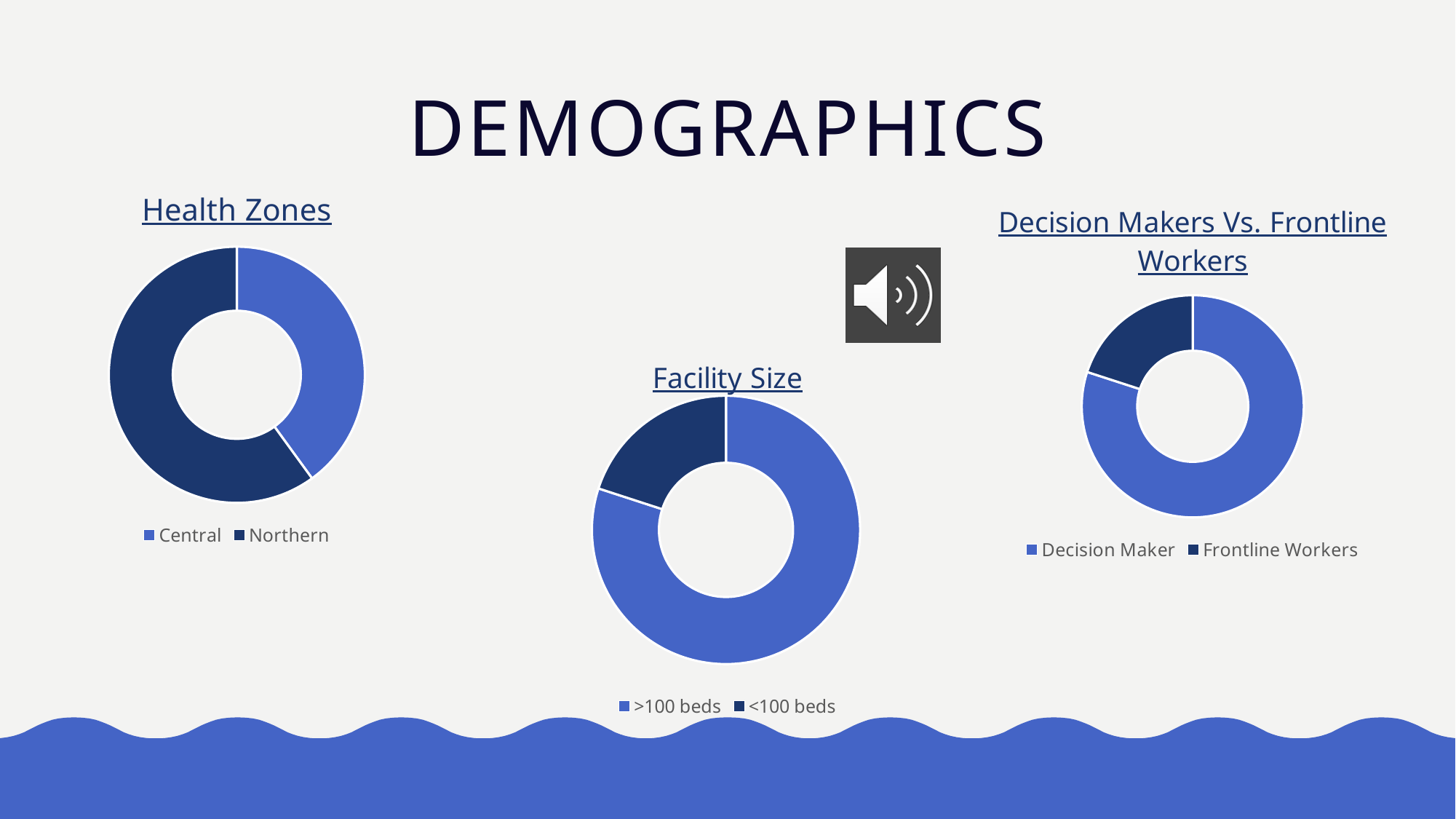
In the Decision Makers Vs. Frontline Workers chart, which is larger, Decision Maker or Frontline Workers? Decision Maker How many categories does the Health Zones chart show? 2 In the Facility Size chart, which category has the largest share? >100 beds How many entries does the legend of the Decision Makers Vs. Frontline Workers chart list? 2 In the Health Zones chart, which category has the smallest share? Central In the Health Zones chart, which category has the larger share, Central or Northern? Northern How many categories does the Facility Size chart show? 2 What are the two legend entries of the Facility Size chart? >100 beds and <100 beds In the Decision Makers Vs. Frontline Workers chart, which category has the larger share? Decision Maker In the Facility Size chart, which category has the smallest share? <100 beds What kind of chart is the Health Zones chart? Doughnut chart How many charts are shown on the slide? 3